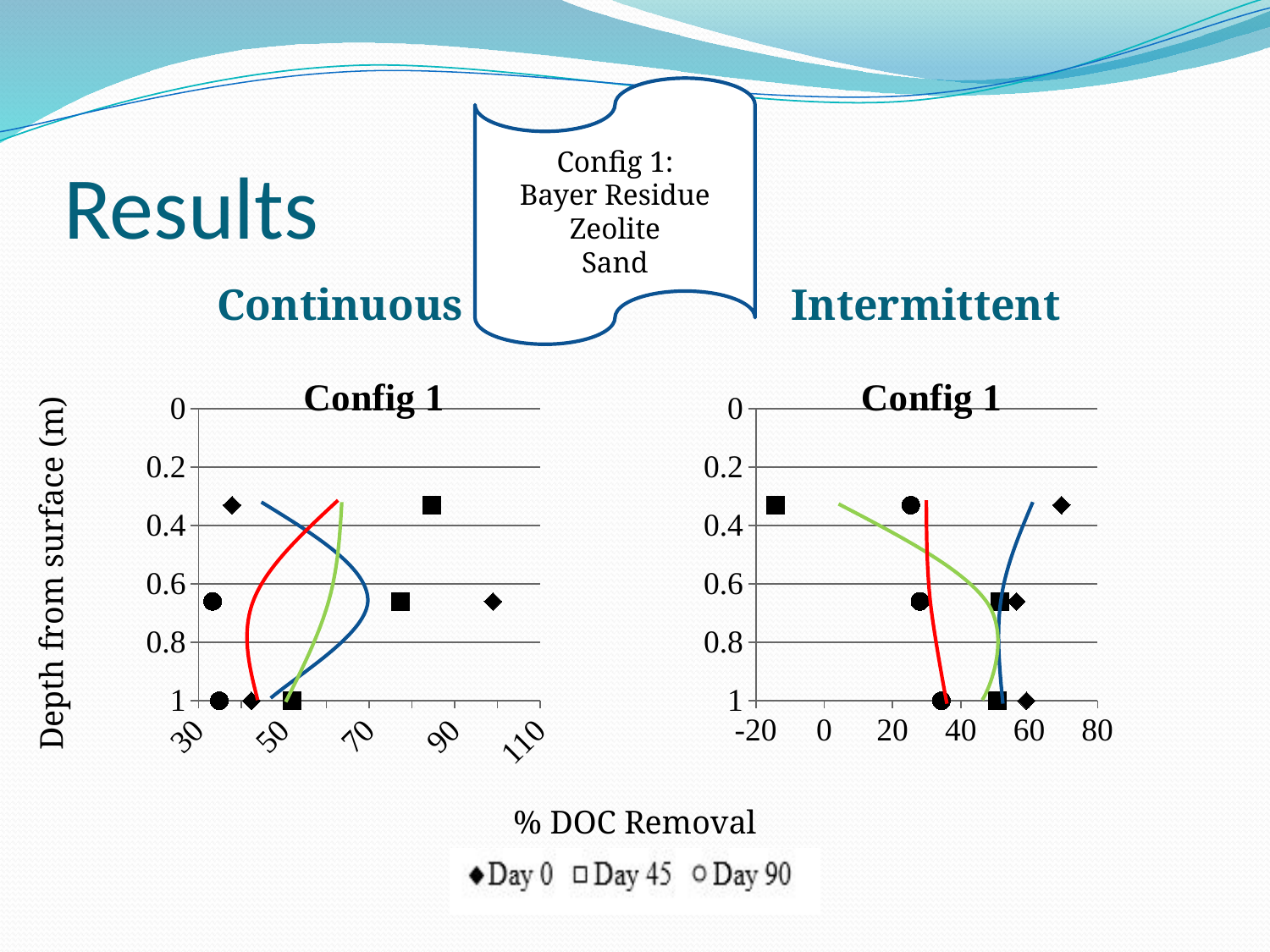
In the Continuous Config 1 chart on the left, at the middle plotted depth, which series has the larger % DOC Removal, Day 0 or Day 90? Day 0 In the Continuous Config 1 chart on the left, is the Day 45 value at the shallowest plotted depth greater or less than 70? greater In the Continuous Config 1 chart on the left, is the Day 90 value at depth 1 m greater or less than 50? less In the Intermittent Config 1 chart on the right, is the Day 0 value at the shallowest plotted depth greater or less than 60? greater What is the x-axis label shared by the two charts? % DOC Removal How many depth points are plotted for the Day 0 series in the Intermittent Config 1 chart on the right? 3 What are the legend entries for the charts? Day 0, Day 45, Day 90 How many series does the legend list for the charts? 3 In the Intermittent Config 1 chart on the right, at the shallowest plotted depth, which series has the larger % DOC Removal, Day 45 or Day 90? Day 90 What kind of chart is the Continuous Config 1 chart on the left? scatter chart